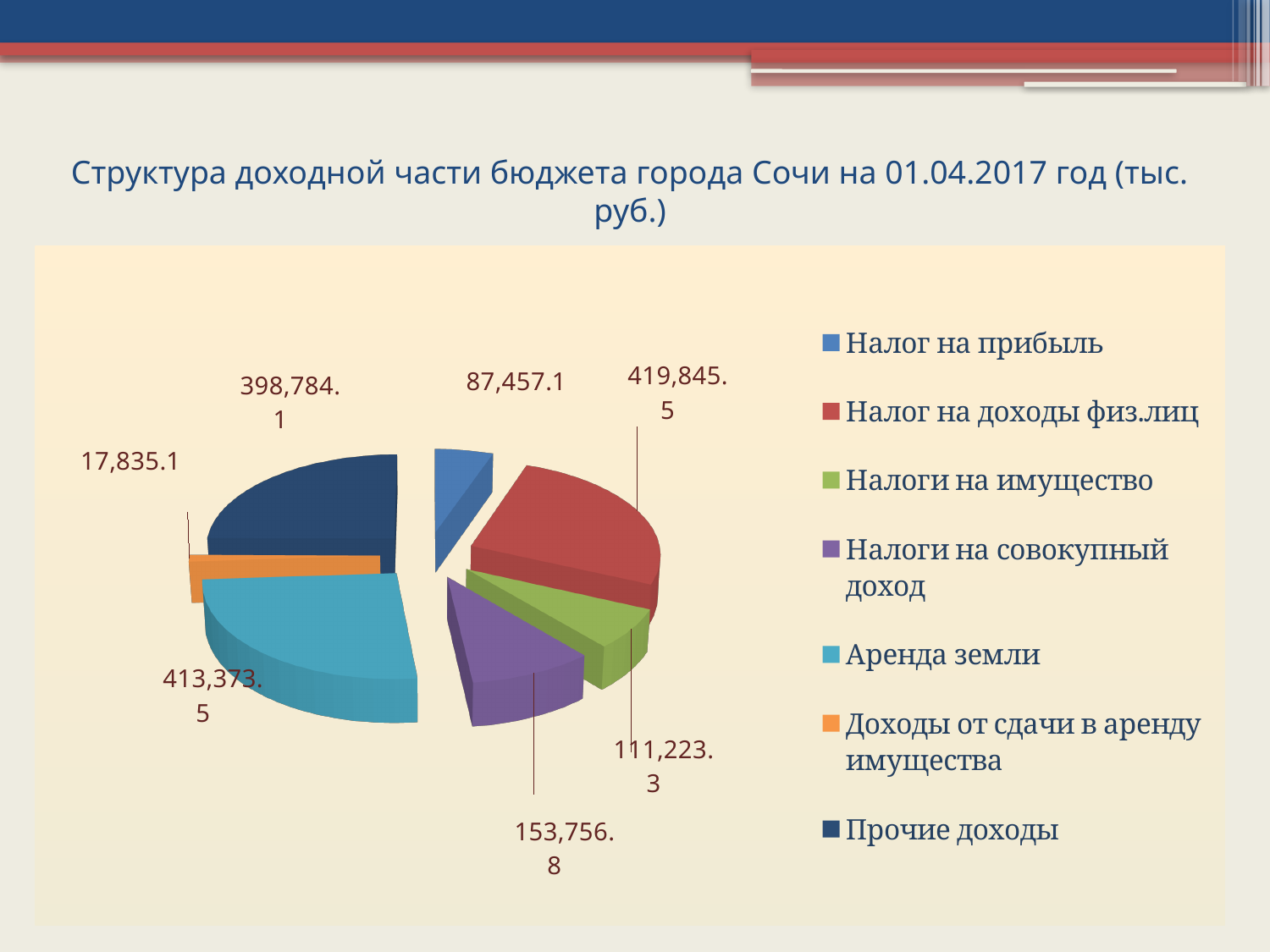
What is the value for Прочие доходы? 398,784.1 What is the value for Аренда земли? 413,373.5 Which category has the smallest value? Доходы от сдачи в аренду имущества What is the title of the chart? Структура доходной части бюджета города Сочи на 01.04.2017 год (тыс. руб.) What is the value for Налог на доходы физ.лиц? 419,845.5 Which category has the largest value? Налог на доходы физ.лиц What type of chart is shown on the slide? Pie chart How many categories does the pie chart have? 7 What is the difference between Налоги на совокупный доход and Налоги на имущество? 42,533.5 Which is larger, Прочие доходы or Налог на прибыль? Прочие доходы What is the value for Доходы от сдачи в аренду имущества? 17,835.1 What is the value for Налог на прибыль? 87,457.1